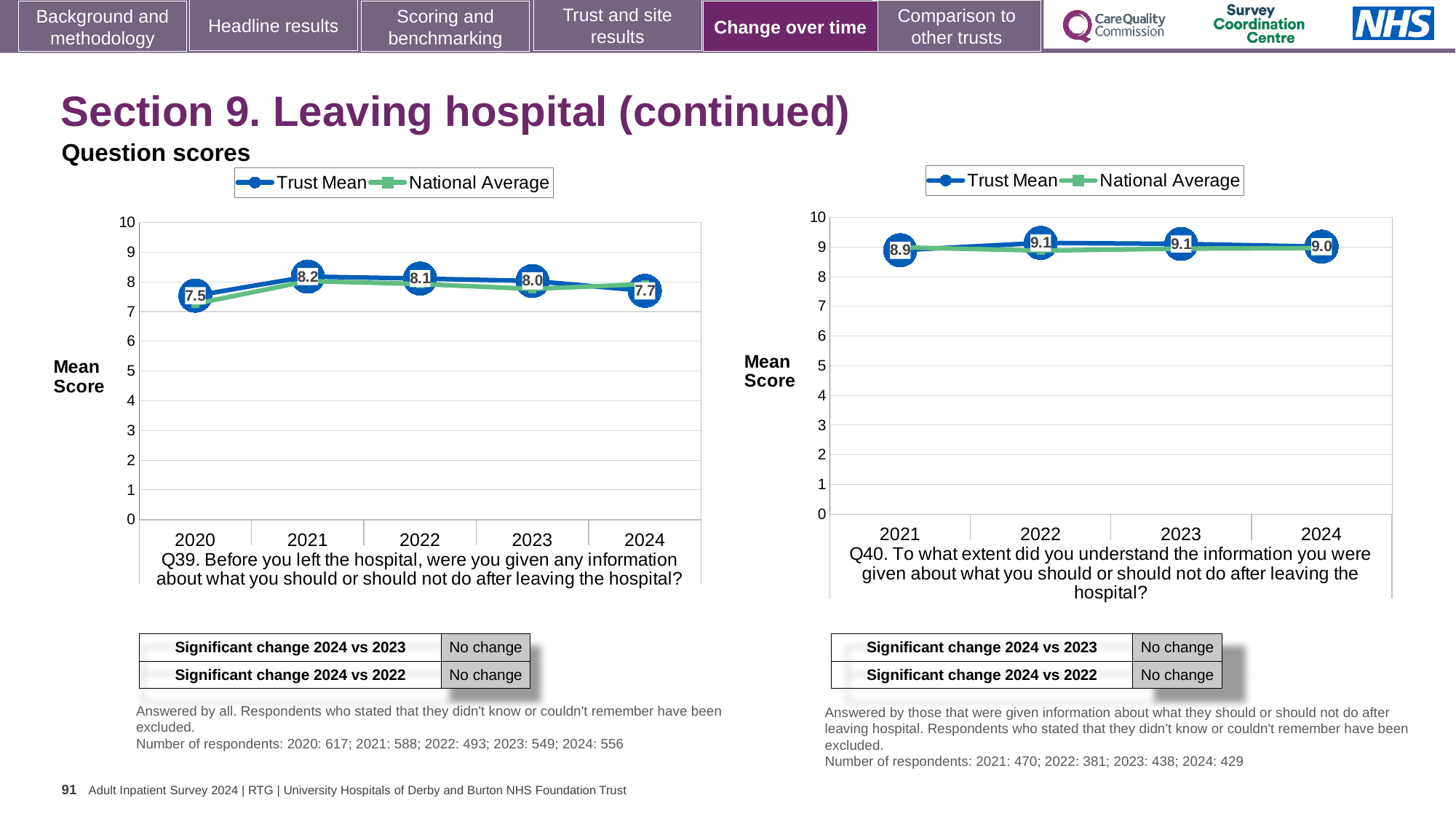
On the Q40 chart (right), is the Trust Mean score for 2022 greater or less than 8? greater On the Q39 chart (left), what is the Trust Mean score for 2021? 8.2 On the Q39 chart (left), does the Trust Mean score rise or fall from 2021 to 2024? Fall On the Q39 chart (left), what is the Trust Mean score for 2024? 7.7 On the Q40 chart (right), what is the Trust Mean score for 2024? 9.0 On the Q39 chart (left), what is the difference between the Trust Mean scores for 2021 and 2024? 0.5 On the Q40 chart (right), what is the Trust Mean score for 2021? 8.9 On the Q39 chart (left), how many years are shown on the x axis? 5 On the Q40 chart (right), how many series does the legend list? 2 On the Q39 chart (left), which year has the lowest Trust Mean score? 2020 On the Q39 chart (left), which year has the highest Trust Mean score? 2021 What kind of chart is the Q40 chart (right)? Line chart